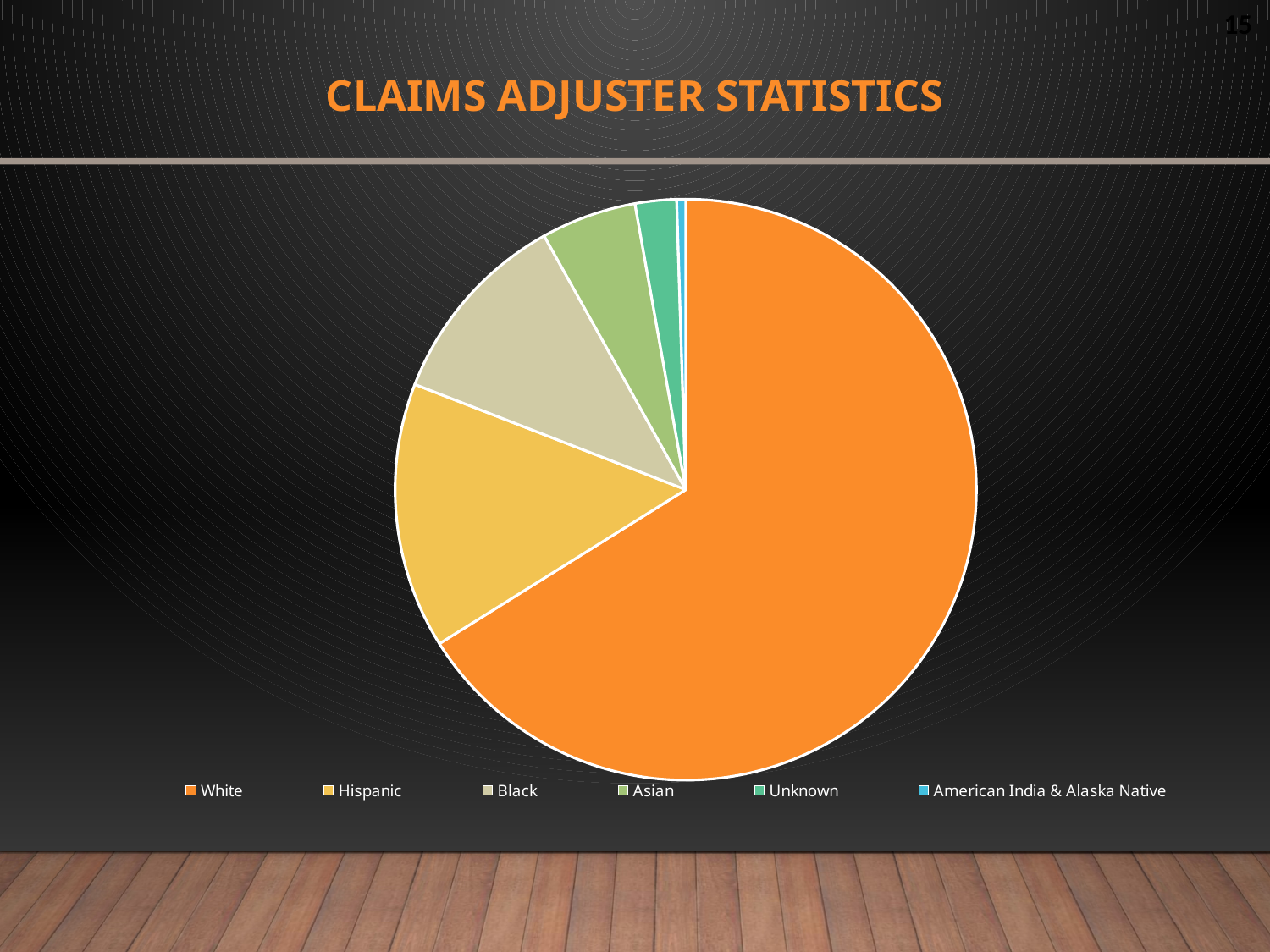
Which category has the smallest slice of the pie chart? American India & Alaska Native What kind of chart is shown on the slide? pie chart Which slice is larger, Hispanic or Black? Hispanic How many categories does the pie chart show? 6 Which category has the largest slice of the pie chart? White What is the title of the slide containing the pie chart? Claims Adjuster Statistics Which slice is larger, Asian or Unknown? Asian Which slice is larger, Black or Asian? Black Which category is shown in orange in the pie chart? White